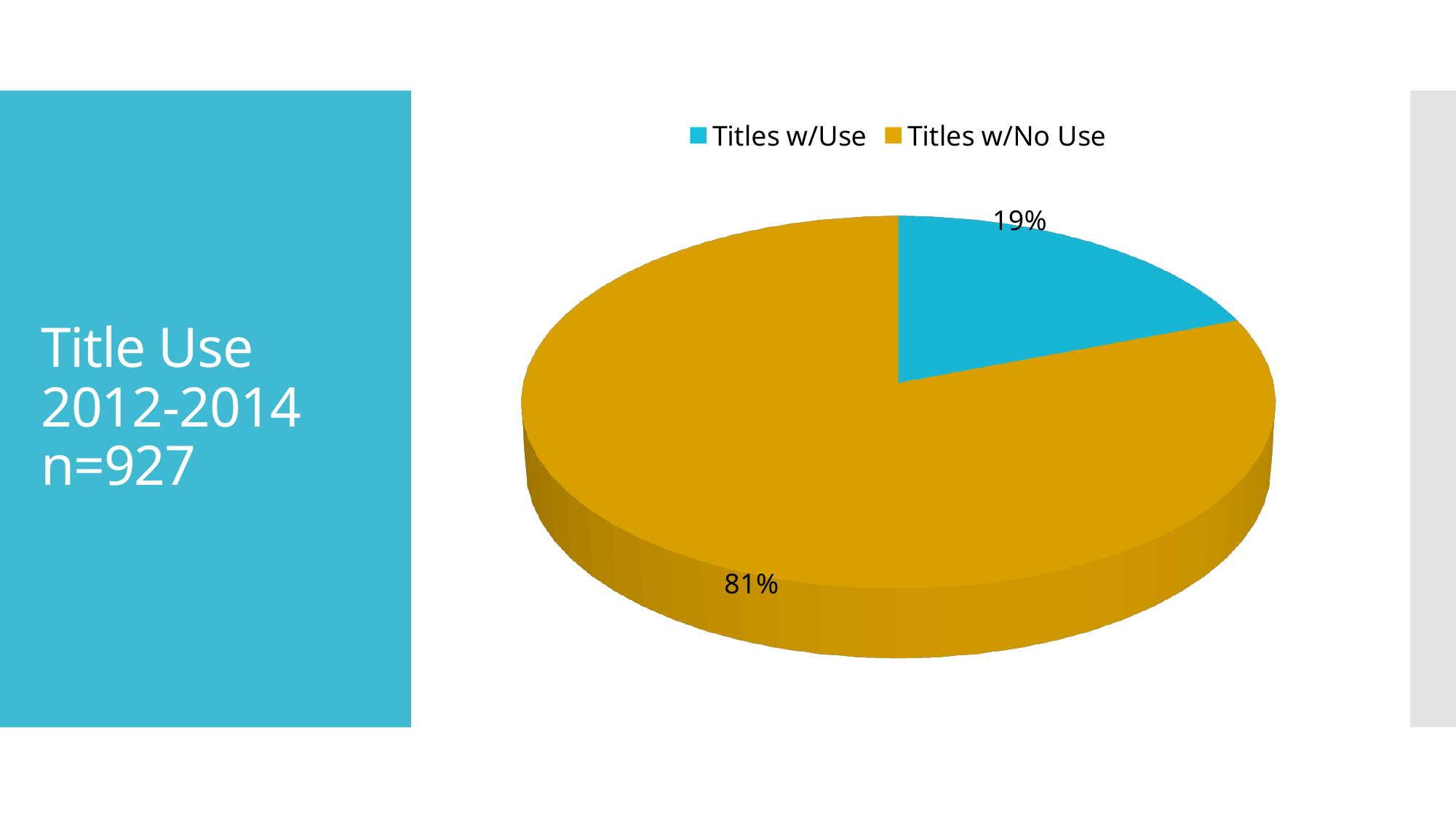
What kind of chart is shown on the slide? pie chart Which slice is the smallest? Titles w/Use What colour is the Titles w/Use slice? blue What is the sample size stated in the slide title? n=927 What share of the pie is labelled Titles w/Use? 19% Which is larger, Titles w/Use or Titles w/No Use? Titles w/No Use How many slices does the pie chart have? 2 What is the difference in percentage points between Titles w/No Use and Titles w/Use? 62 Which slice is the largest? Titles w/No Use What share of the pie is labelled Titles w/No Use? 81% How many entries does the legend list? 2